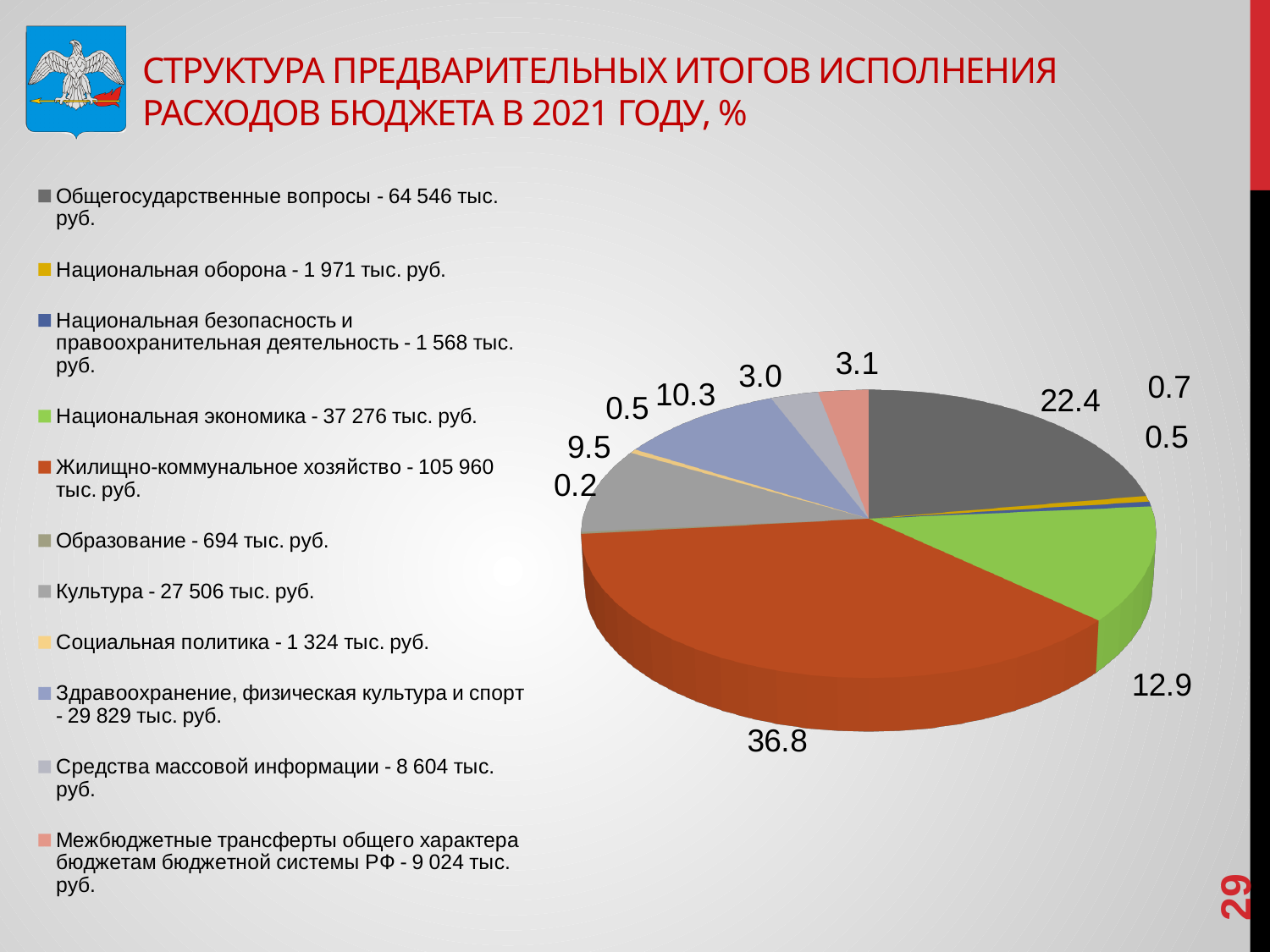
What share of budget expenditure does Жилищно-коммунальное хозяйство account for in the pie chart? 36.8 What type of chart is shown on the slide? Pie chart According to the legend, how much was spent on Средства массовой информации? 8 604 тыс. руб. What value is shown for Общегосударственные вопросы in the pie chart? 22.4 Which category has the smallest slice of the pie chart? Образование How many categories does the pie chart legend list? 11 What value is shown for Культура in the pie chart? 9.5 What value is shown for Здравоохранение, физическая культура и спорт in the pie chart? 10.3 What value is shown for Национальная экономика in the pie chart? 12.9 Which is larger: the value for Здравоохранение, физическая культура и спорт or the value for Культура? Здравоохранение, физическая культура и спорт What is the difference between the values for Жилищно-коммунальное хозяйство and Общегосударственные вопросы? 14.4 Which category has the largest slice of the pie chart? Жилищно-коммунальное хозяйство